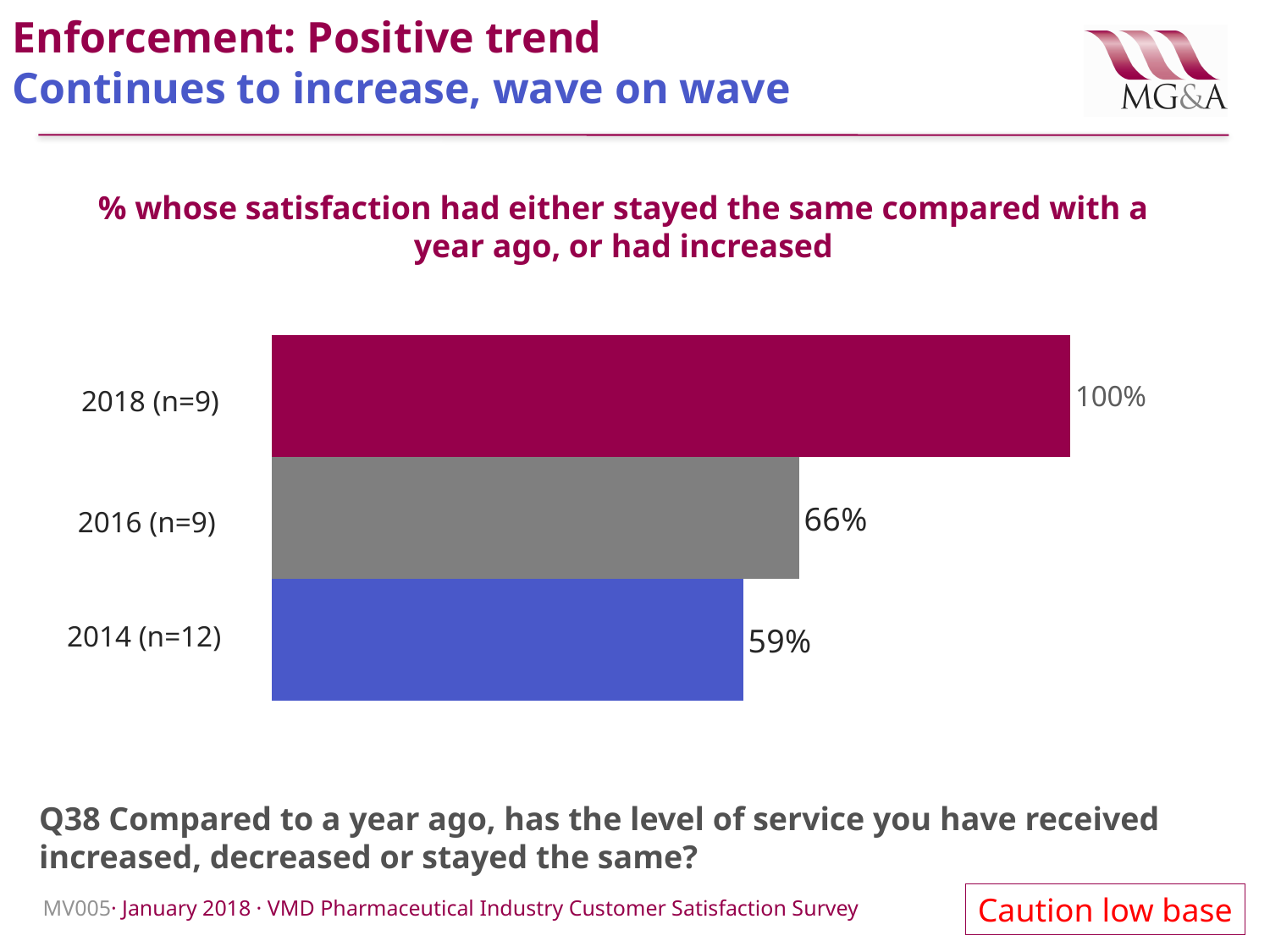
What kind of chart is shown on the slide? Bar chart What is the difference between the 2018 and 2016 values? 34 percentage points Which is larger, the value for 2016 or the value for 2014? 2016 What is the value for 2016 (n=9)? 66% What is the value for 2014 (n=12)? 59% What is the value for 2018 (n=9)? 100% What is the title of the chart? % whose satisfaction had either stayed the same compared with a year ago, or had increased Do the values rise or fall from 2014 to 2018? Rise Which year has the highest value? 2018 (n=9) Which year has the lowest value? 2014 (n=12) How many years are shown in the chart? 3 What is the difference between the 2016 and 2014 values? 7 percentage points